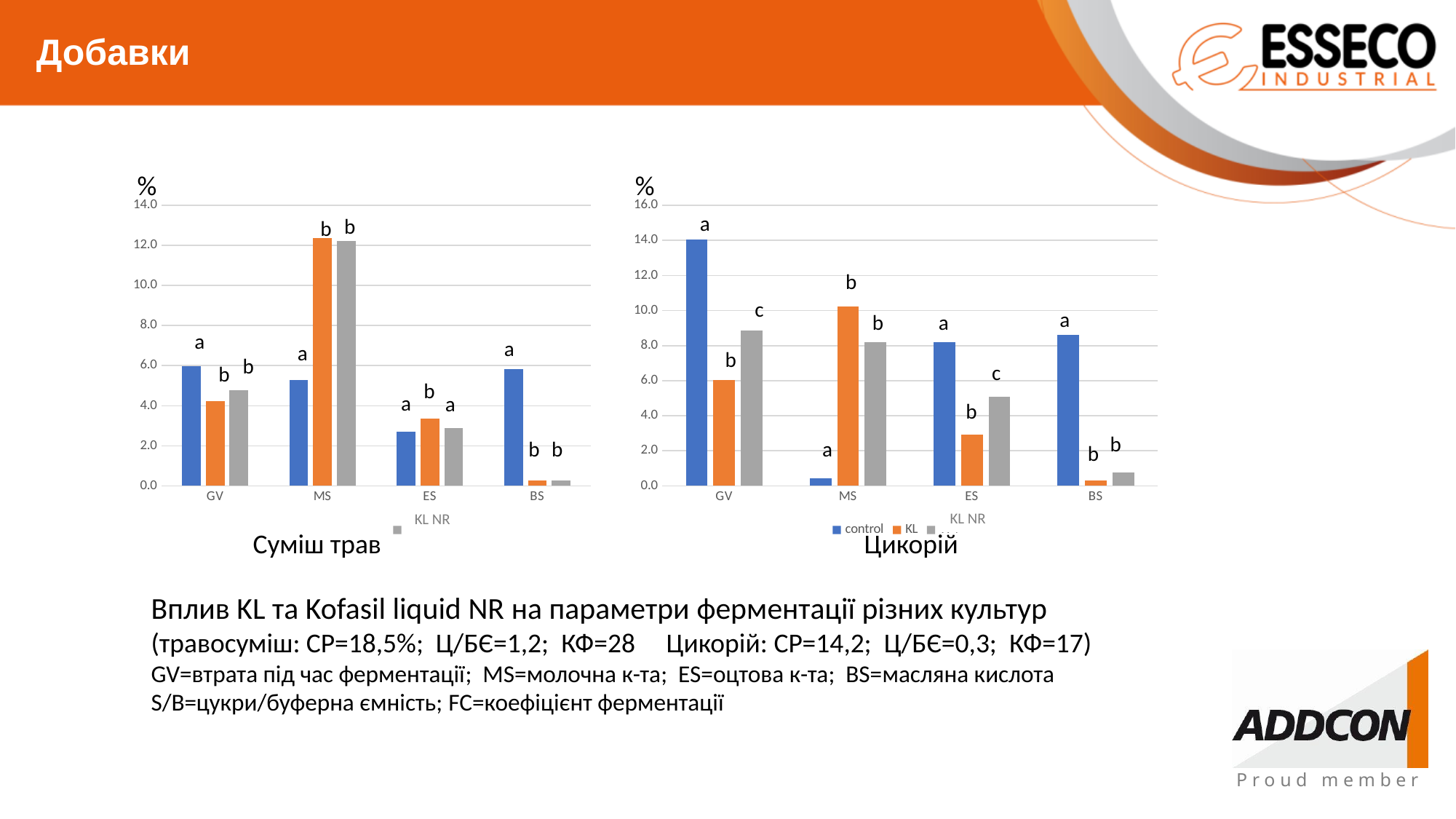
In the right chart "Цикорій", which category has the lowest KL (orange) bar? BS In the left chart "Суміш трав", is the KL (orange) value for MS greater or less than 10.0? greater What kind of chart is the left chart titled "Суміш трав"? bar chart In the right chart "Цикорій", which category has the highest control (blue) bar? GV How many categories are shown on the x axis of the left chart "Суміш трав"? 4 In the right chart "Цикорій", is the control value for GV greater or less than 12.0? greater In the right chart "Цикорій", is the control value for MS greater or less than 2.0? less In the left chart "Суміш трав", for BS, which is larger: the control bar or the KL bar? control What is the highest tick value shown on the y axis of the right chart "Цикорій"? 16.0 In the left chart "Суміш трав", which category has the highest KL (orange) bar? MS How many series does the legend of the right chart "Цикорій" list? 3 In the right chart "Цикорій", for GV, which is larger: the KL bar or the KL NR bar? KL NR